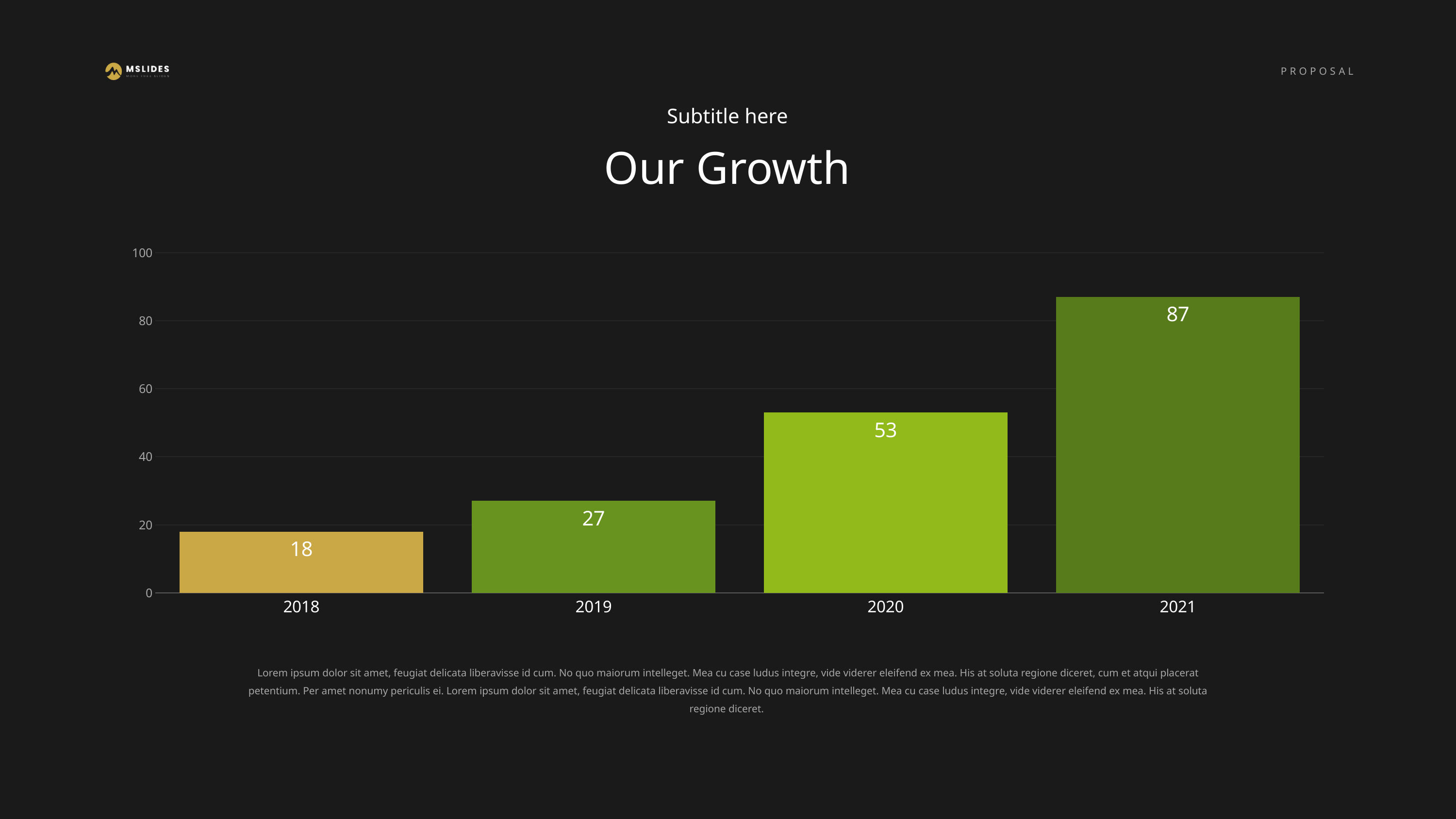
What is the value for 2021? 87 What is the difference between the values for 2019 and 2018? 9 Do the values rise or fall from 2018 to 2021? rise What kind of chart is shown on the slide? bar chart How many years are shown on the x axis? 4 What is the value for 2018? 18 Which year has the highest value? 2021 Which year has the lowest value? 2018 What is the value for 2020? 53 What is the difference between the values for 2021 and 2020? 34 Which is larger, the value for 2019 or the value for 2020? 2020 Is the value for 2021 greater or less than 80? greater